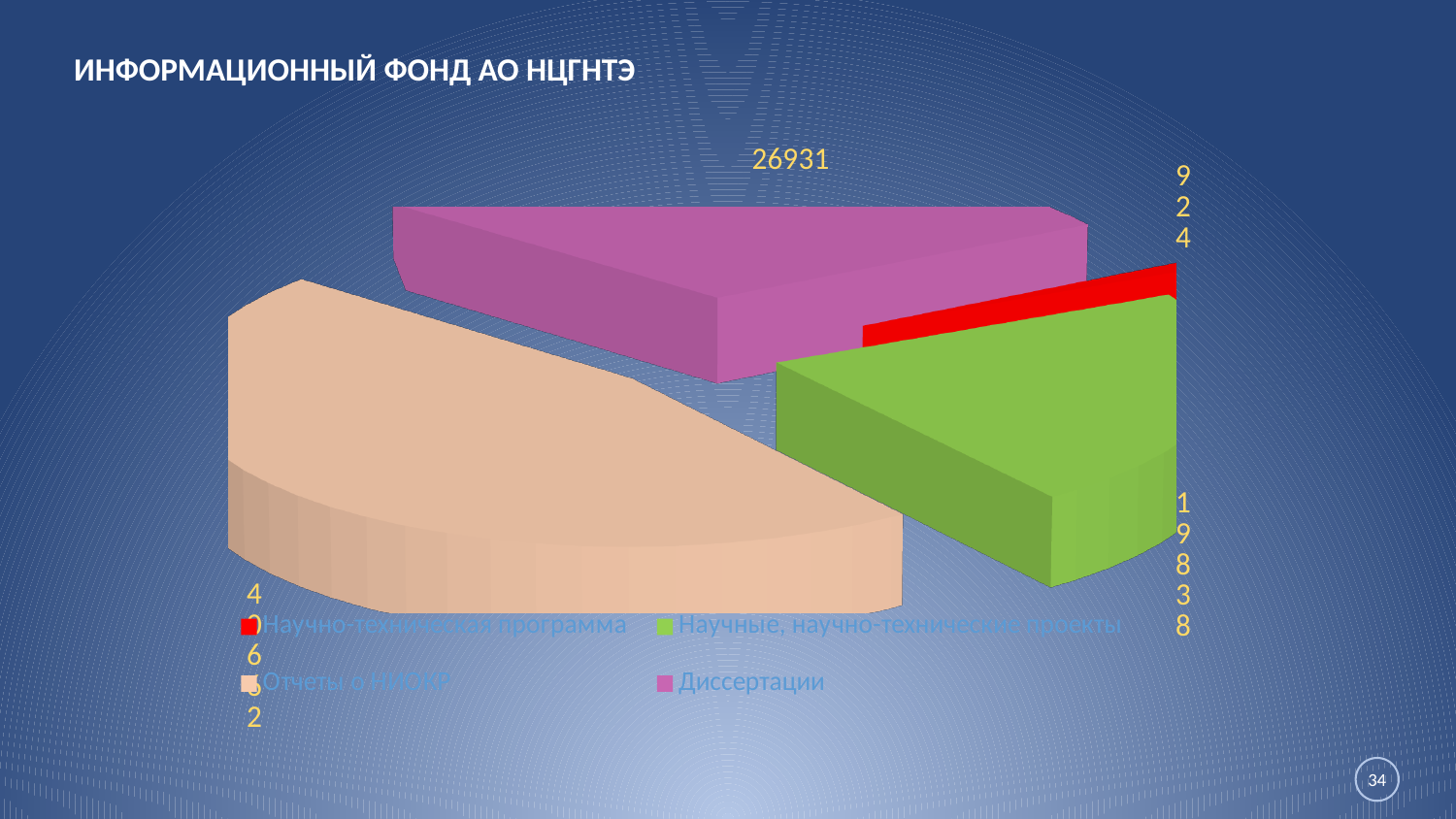
What colour is the Диссертации slice? Pink Which category has the largest slice of the pie? Отчеты о НИОКР What is the difference between the values for Диссертации and Научные, научно-технические проекты? 7093 Which is larger, Диссертации or Научные, научно-технические проекты? Диссертации How many categories does the legend of the pie chart list? 4 What is the title of the slide? ИНФОРМАЦИОННЫЙ ФОНД АО НЦГНТЭ What is the value shown for Научные, научно-технические проекты? 19838 What is the value shown for Диссертации? 26931 What is the difference between the values for Научные, научно-технические проекты and Научно-техническая программа? 18914 Which category has the smallest slice of the pie? Научно-техническая программа What is the value shown for Научно-техническая программа? 924 What kind of chart is shown on the slide? Pie chart